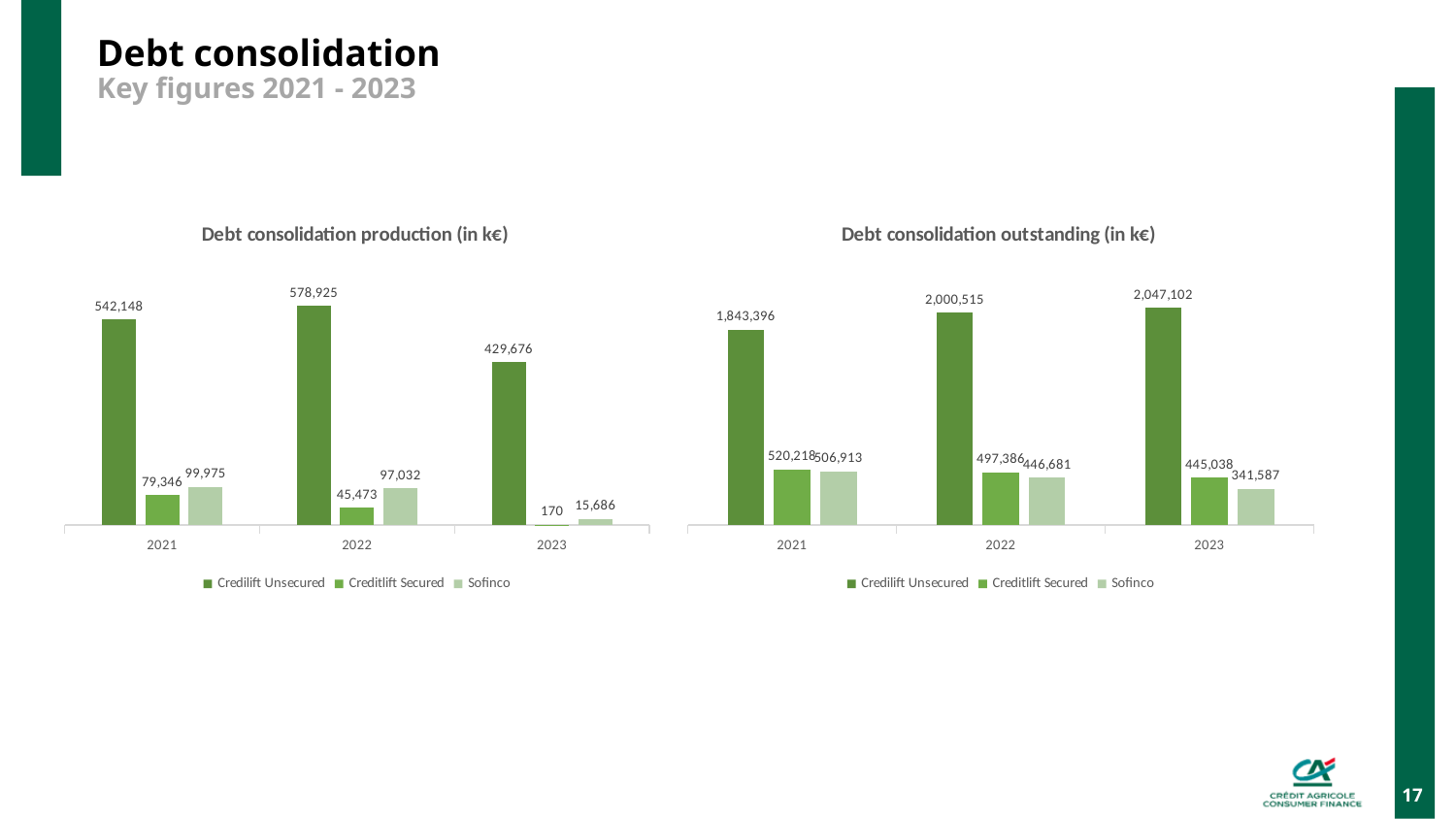
In the 'Debt consolidation outstanding (in k€)' chart, does the Sofinco value rise or fall from 2021 to 2023? fall What kind of chart is the 'Debt consolidation outstanding (in k€)' chart? bar chart In the 'Debt consolidation outstanding (in k€)' chart, what is the value for Credilift Unsecured in 2023? 2,047,102 In the 'Debt consolidation production (in k€)' chart, what is the value for Sofinco in 2023? 15,686 In the 'Debt consolidation outstanding (in k€)' chart, what is the difference between the Creditlift Secured and Sofinco values in 2023? 103,451 In the 'Debt consolidation production (in k€)' chart, what is the value for Credilift Unsecured in 2022? 578,925 In the 'Debt consolidation production (in k€)' chart, what is the difference between the Credilift Unsecured values for 2022 and 2023? 149,249 How many series does the legend of the 'Debt consolidation production (in k€)' chart list? 3 In the 'Debt consolidation outstanding (in k€)' chart, what is the value for Sofinco in 2022? 446,681 In the 'Debt consolidation production (in k€)' chart, which is larger in 2021: Creditlift Secured or Sofinco? Sofinco In the 'Debt consolidation outstanding (in k€)' chart, which year has the highest value for Credilift Unsecured? 2023 In the 'Debt consolidation production (in k€)' chart, which year has the lowest value for Creditlift Secured? 2023